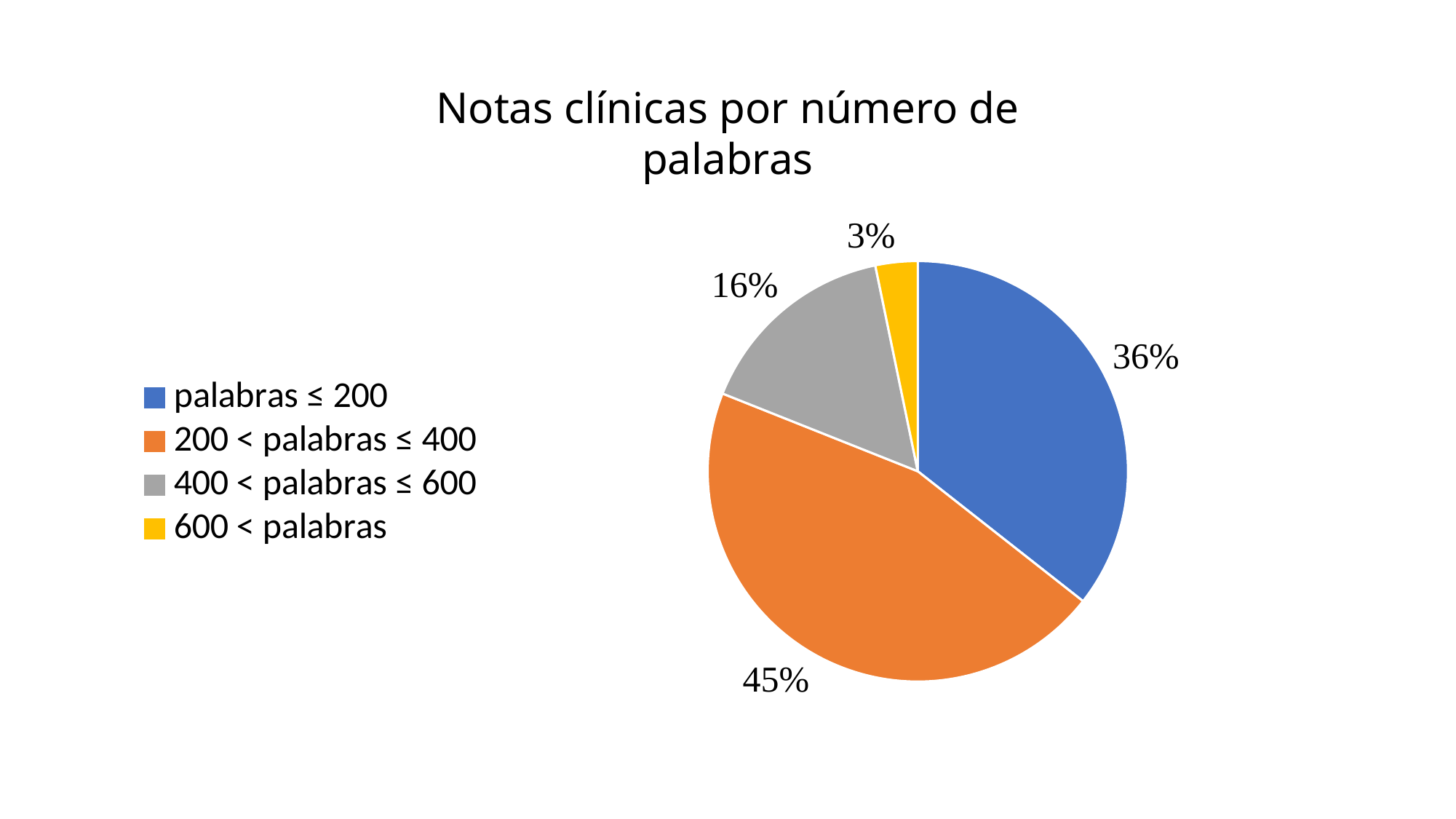
Which is larger: the share for 'palabras ≤ 200' or the share for '400 < palabras ≤ 600'? palabras ≤ 200 What share of the pie does the '200 < palabras ≤ 400' slice represent? 45% What kind of chart is shown on the slide? pie chart What is the difference in percentage points between the '200 < palabras ≤ 400' slice and the 'palabras ≤ 200' slice? 9 What share of the pie does the '400 < palabras ≤ 600' slice represent? 16% Which category has the smallest share of the pie? 600 < palabras What is the title of the chart? Notas clínicas por número de palabras What colour is the slice for '600 < palabras'? yellow What share of the pie does the '600 < palabras' slice represent? 3% How many categories does the pie chart show? 4 What share of the pie does the 'palabras ≤ 200' slice represent? 36% Which category has the largest share of the pie? 200 < palabras ≤ 400